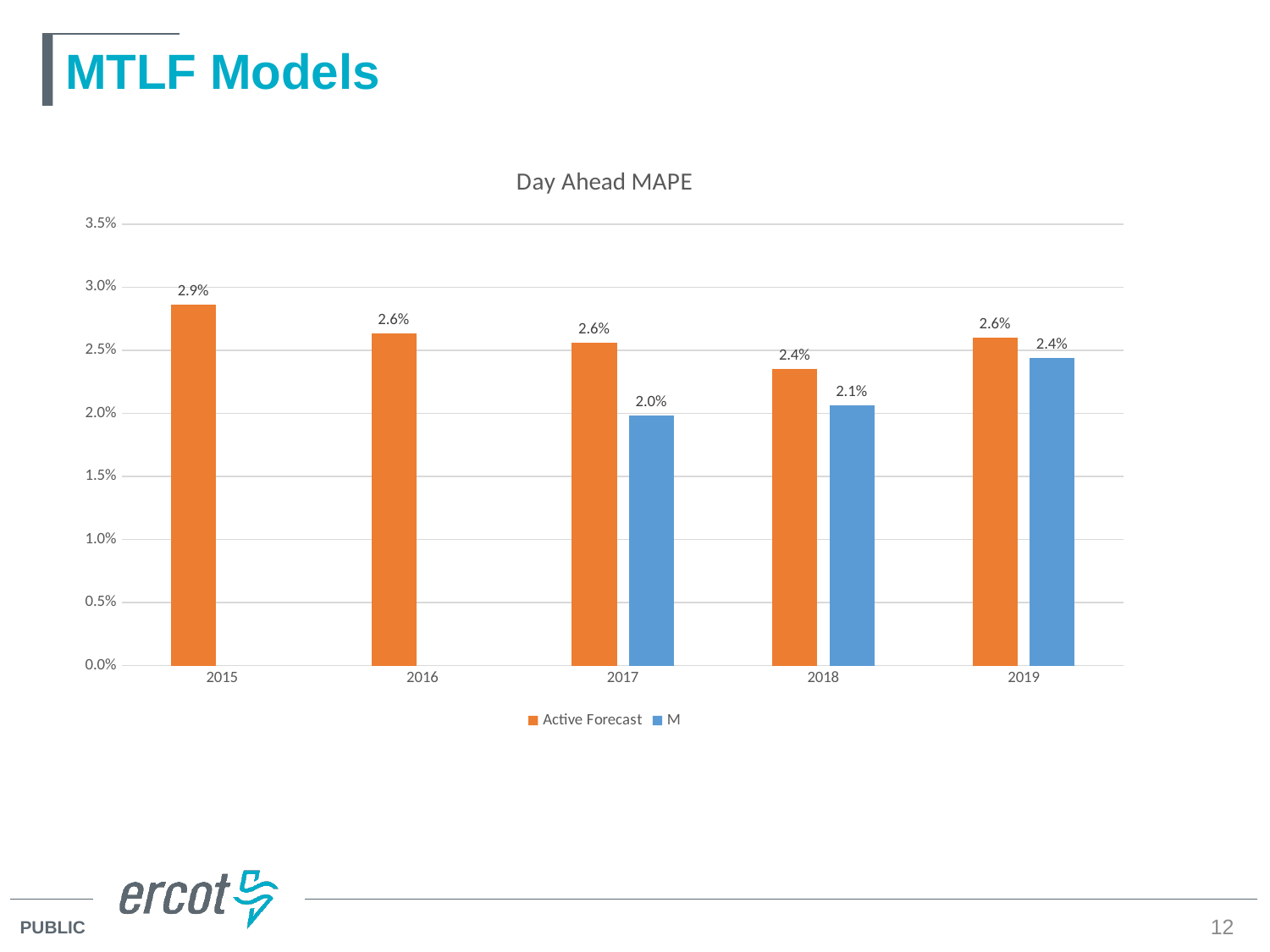
What is the difference between the Active Forecast and M values in 2017? 0.6% How many series does the legend list? 2 What kind of chart is the Day Ahead MAPE chart? Bar chart What is the Active Forecast value for 2018? 2.4% In 2018, which series has the larger value, Active Forecast or M? Active Forecast Is the Active Forecast value for 2015 greater or less than 2.5%? greater What is the M value for 2017 in the Day Ahead MAPE chart? 2.0% Which year has the highest Active Forecast value? 2015 What is the Active Forecast value for 2015 in the Day Ahead MAPE chart? 2.9% Which year has the lowest M value? 2017 Do the M values rise or fall from 2017 to 2019? Rise How many years are shown on the x axis of the Day Ahead MAPE chart? 5